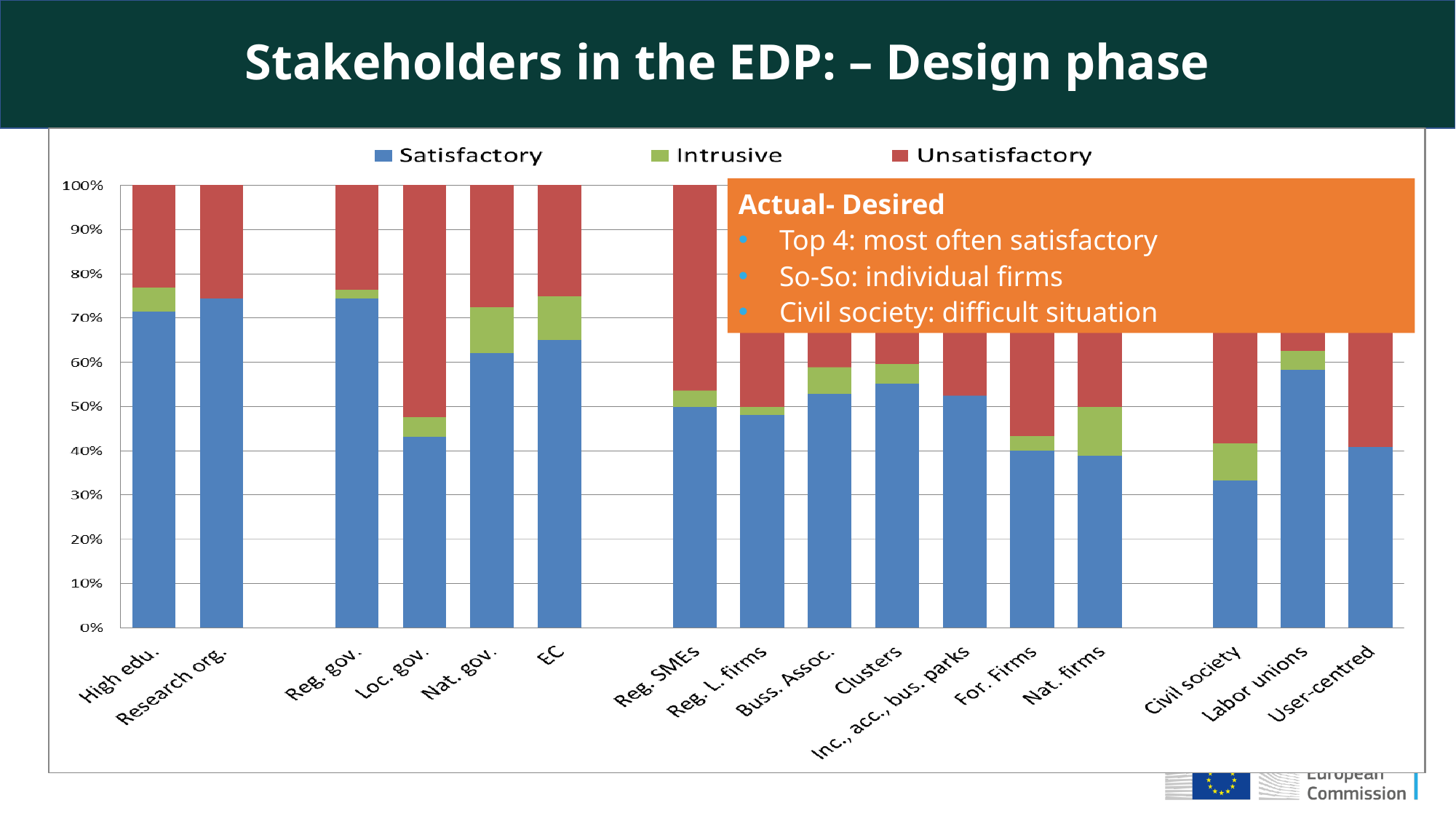
What kind of chart is shown on the slide? Stacked bar chart How many series does the chart legend list? 3 How many stakeholder categories are plotted along the x axis? 16 Which series is shown in red in the chart legend? Unsatisfactory What is the total of the stacked bar for High edu.? 100% Is the Satisfactory value for High edu. greater or less than 60%? greater Which category has the lowest Satisfactory share? Civil society Is the Satisfactory value for Civil society greater or less than 40%? less Is the Satisfactory value for Labor unions greater or less than 50%? greater Which has the larger Satisfactory share, Loc. gov. or Nat. gov.? Nat. gov. Which has the larger Satisfactory share, Civil society or Labor unions? Labor unions